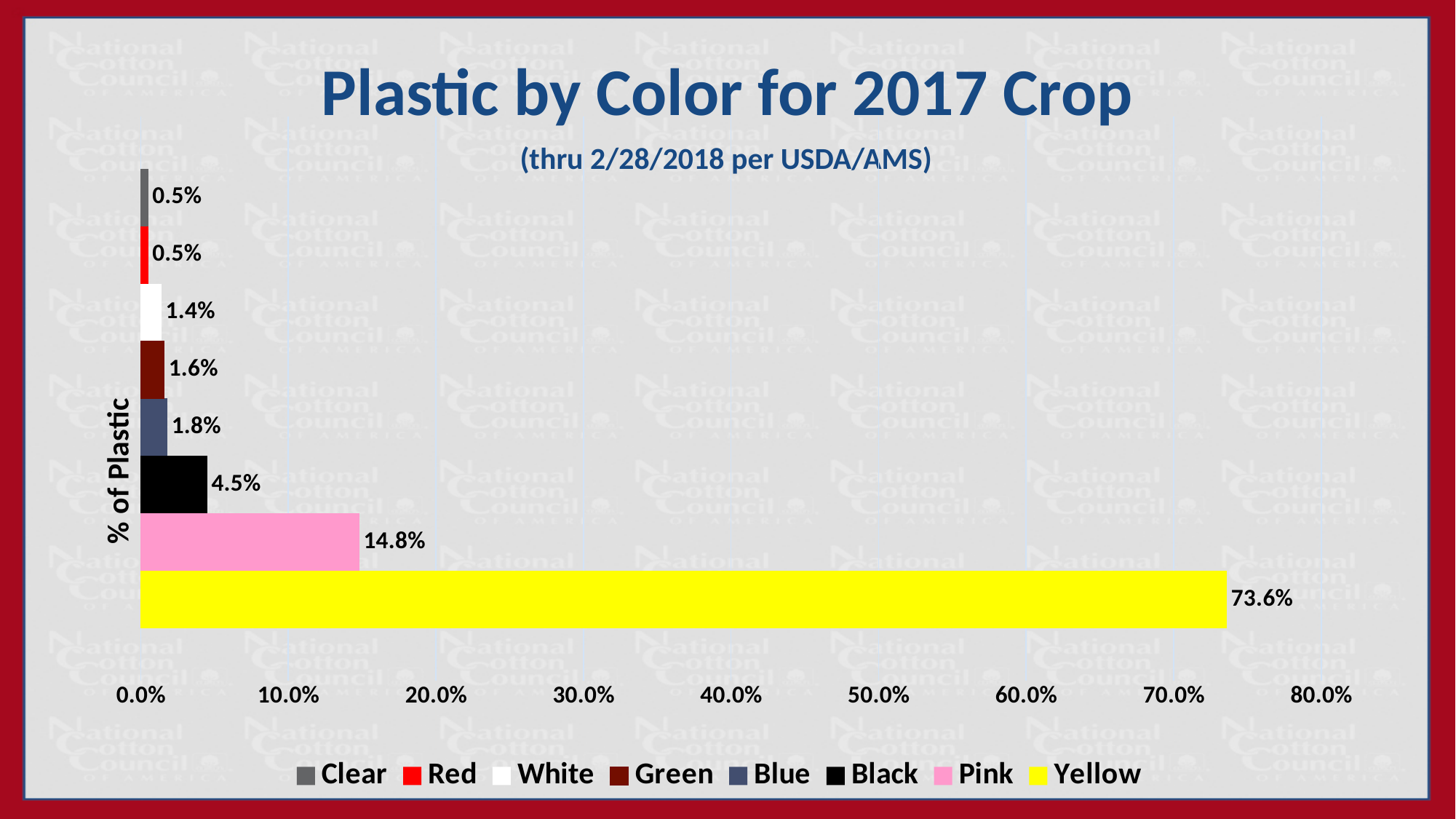
How many color categories are plotted in the chart? 8 What percentage of plastic is Yellow? 73.6% What percentage of plastic is Pink? 14.8% Which is larger, the percentage for Blue or for White? Blue What percentage of plastic is Green? 1.6% Is the value for Yellow greater or less than 70.0%? greater What is the difference between the Black and Blue percentages? 2.7% What kind of chart is shown on the slide? Bar chart What is the title of the chart? Plastic by Color for 2017 Crop Which color accounts for the largest share of plastic? Yellow What is the difference between the Yellow and Pink percentages? 58.8% What percentage of plastic is Black? 4.5%